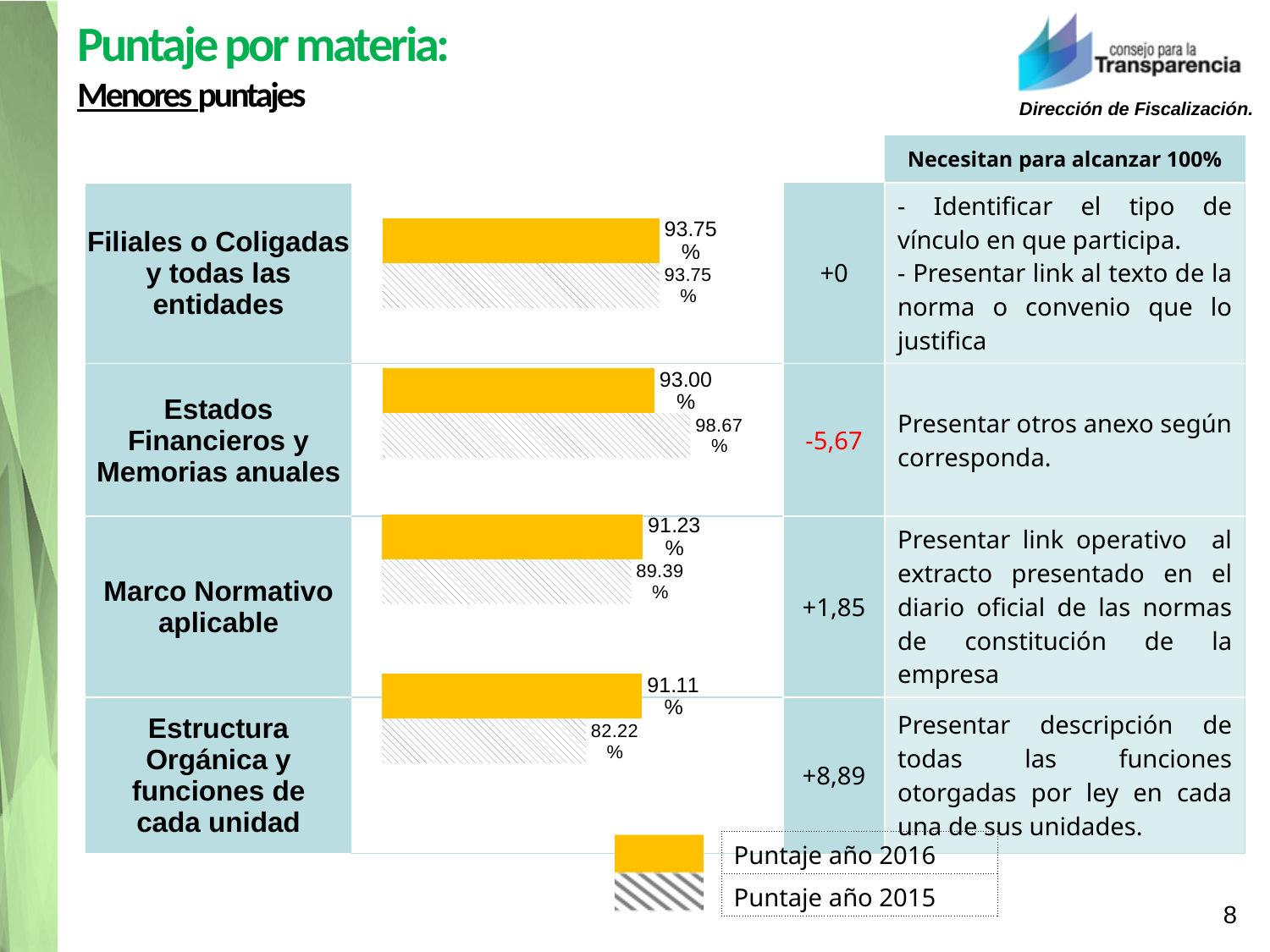
What is the 2015 score (Puntaje año 2015) for Estructura Orgánica y funciones de cada unidad? 82.22% Which category has the highest 2016 score (Puntaje año 2016)? Filiales o Coligadas y todas las entidades For Estados Financieros y Memorias anuales, which is larger: the 2016 score or the 2015 score? 2015 score What is the difference between the 2016 and 2015 scores for Marco Normativo aplicable? 1.84% How many categories (materias) are shown in the chart? 4 What is the 2016 score (Puntaje año 2016) for Marco Normativo aplicable? 91.23% What is the 2015 score (Puntaje año 2015) for Estados Financieros y Memorias anuales? 98.67% Which category has the lowest 2015 score (Puntaje año 2015)? Estructura Orgánica y funciones de cada unidad How many series does the legend list? 2 Which category has the highest 2015 score (Puntaje año 2015)? Estados Financieros y Memorias anuales For Estructura Orgánica y funciones de cada unidad, which is larger: the 2016 score or the 2015 score? 2016 score What is the 2016 score (Puntaje año 2016) for Filiales o Coligadas y todas las entidades? 93.75%